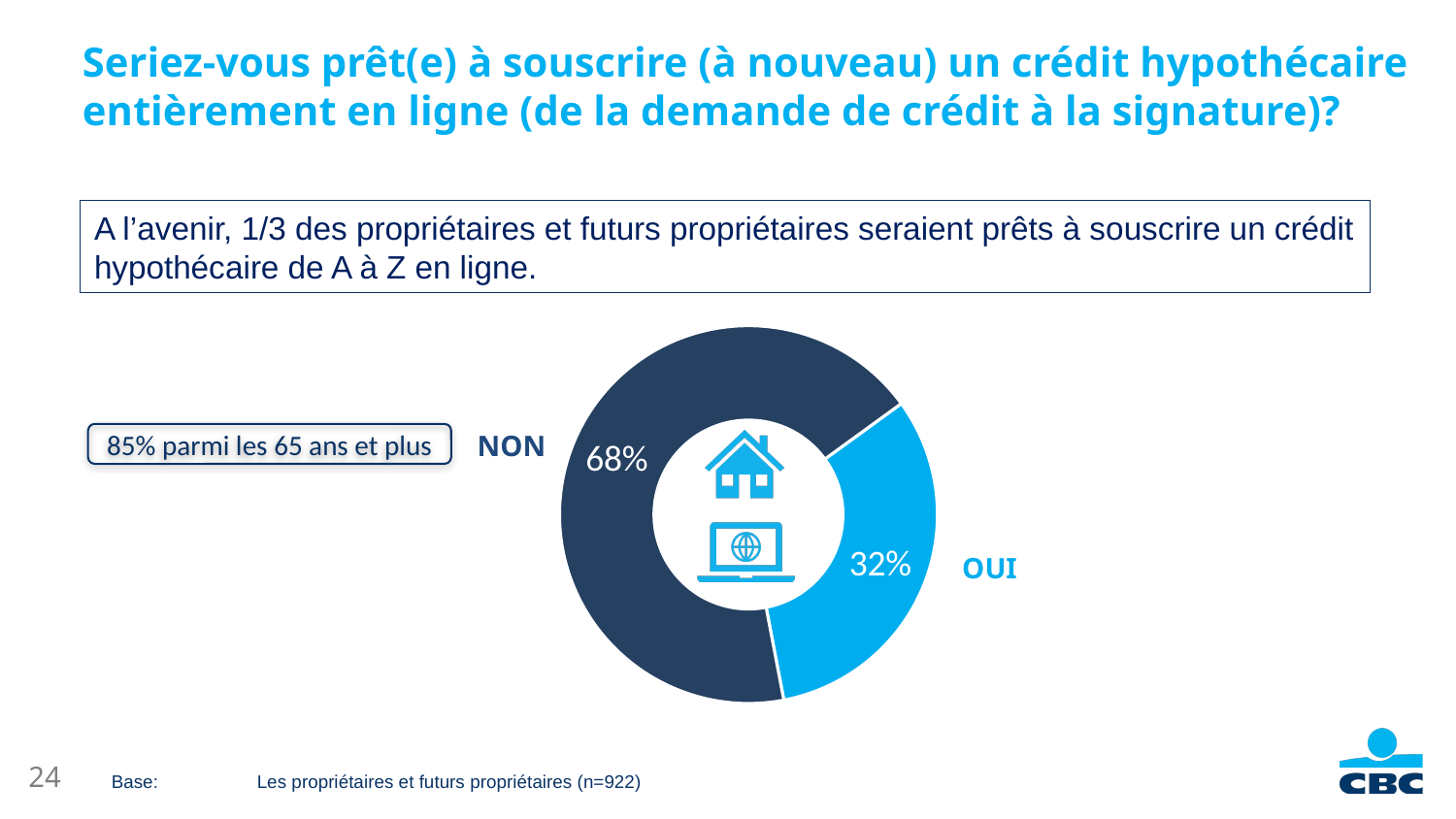
What percentage of respondents answered NON? 68% What is the sample size (n) given in the base note below the chart? 922 Which response has the largest share of the pie? NON What percentage of respondents answered OUI? 32% What is the difference in percentage points between the NON and OUI shares? 36 How many categories are shown in the pie chart? 2 What share of the pie does the OUI slice represent? 32% What colour is the OUI slice of the pie chart? Light blue Which response has the smallest share of the pie? OUI What kind of chart is shown on the slide? Pie chart (doughnut) Which is larger, the share for OUI or the share for NON? NON